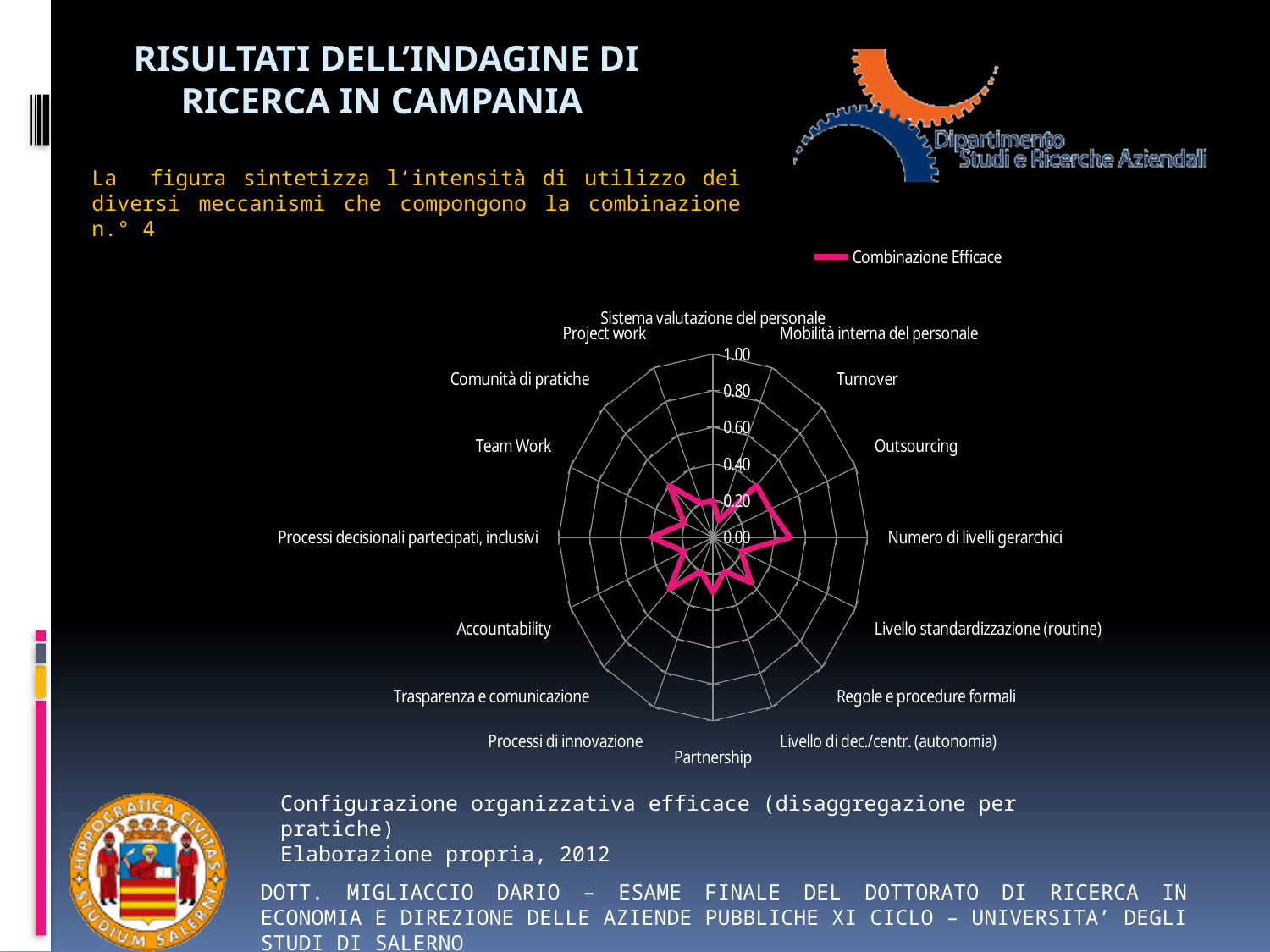
Is the value for Turnover greater or less than 0.60? less Is the value for Partnership greater or less than 0.60? less What is the name of the series shown in the chart legend? Combinazione Efficace How many series does the chart legend list? 1 How many categories (axes) does the radar chart have? 16 Is the value for Outsourcing greater or less than 0.60? less What is the maximum value shown on the radar chart's scale? 1.00 What kind of chart is shown on the slide? Radar chart